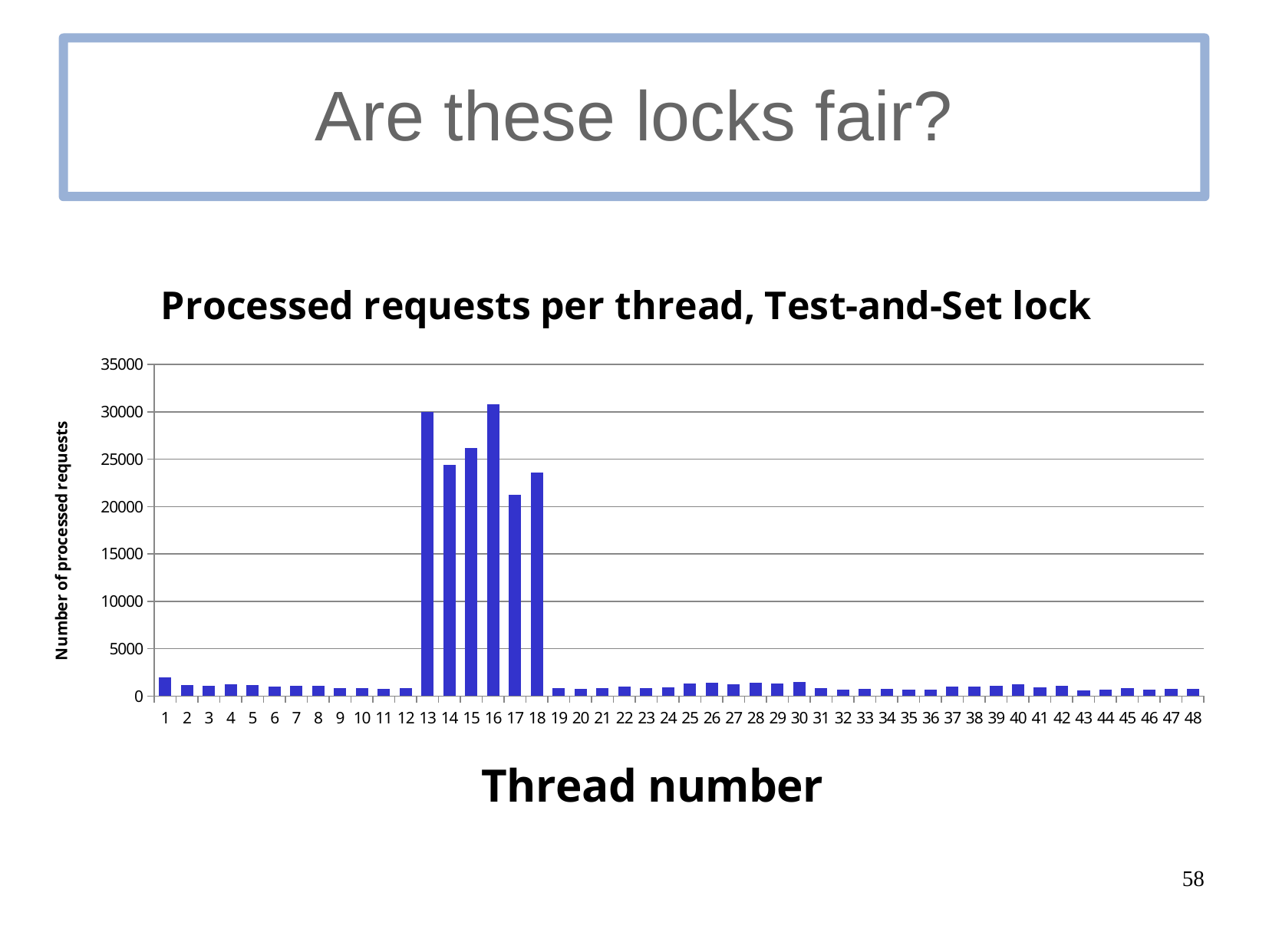
Is the value for thread 13 greater or less than 25000? greater Is the value for thread 18 greater or less than 20000? greater Is the value for thread 30 greater or less than 5000? less What kind of chart is shown on the slide? bar chart Which has a higher value, thread 16 or thread 17? thread 16 How many threads (categories) are plotted on the x axis? 48 What is the title of the chart? Processed requests per thread, Test-and-Set lock Which has a higher value, thread 13 or thread 14? thread 13 Which has a higher value, thread 1 or thread 15? thread 15 What is the label of the x axis of the chart? Thread number